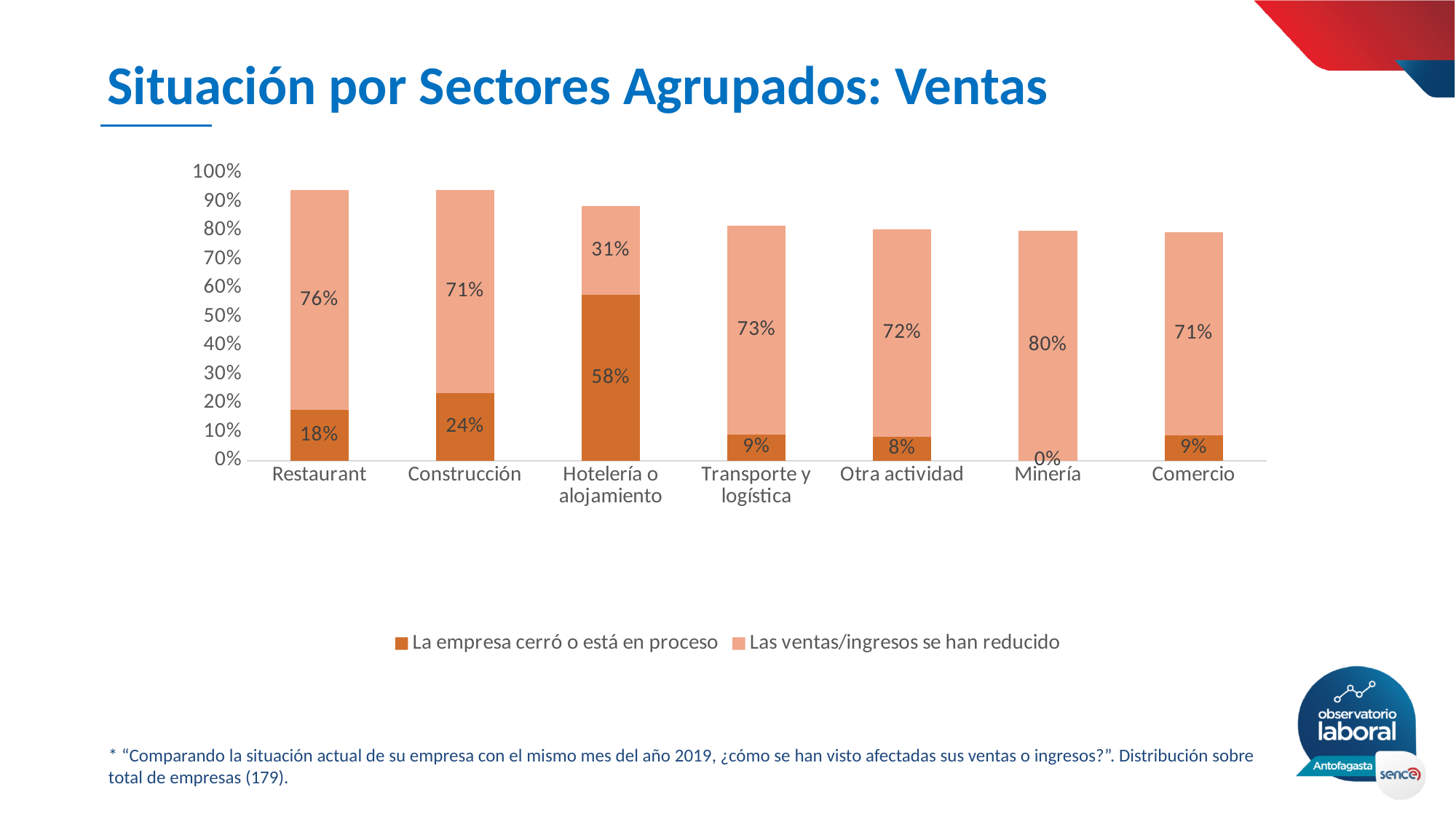
What is the title of the chart slide? Situación por Sectores Agrupados: Ventas What is the difference between the 'Las ventas/ingresos se han reducido' values for Restaurant and Comercio? 5% What is the total of the stacked bar for Restaurant? 94% Which sector has the lowest value for 'La empresa cerró o está en proceso'? Minería What is the value of 'Las ventas/ingresos se han reducido' for Minería? 80% Which is larger: the 'La empresa cerró o está en proceso' value for Restaurant or for Construcción? Construcción What kind of chart is shown on the slide? Stacked bar chart Which sector has the highest value for 'La empresa cerró o está en proceso'? Hotelería o alojamiento How many series does the legend list? 2 How many sectors (categories) are shown on the x axis? 7 What is the value of 'La empresa cerró o está en proceso' for Hotelería o alojamiento? 58% What is the value of 'La empresa cerró o está en proceso' for Construcción? 24%